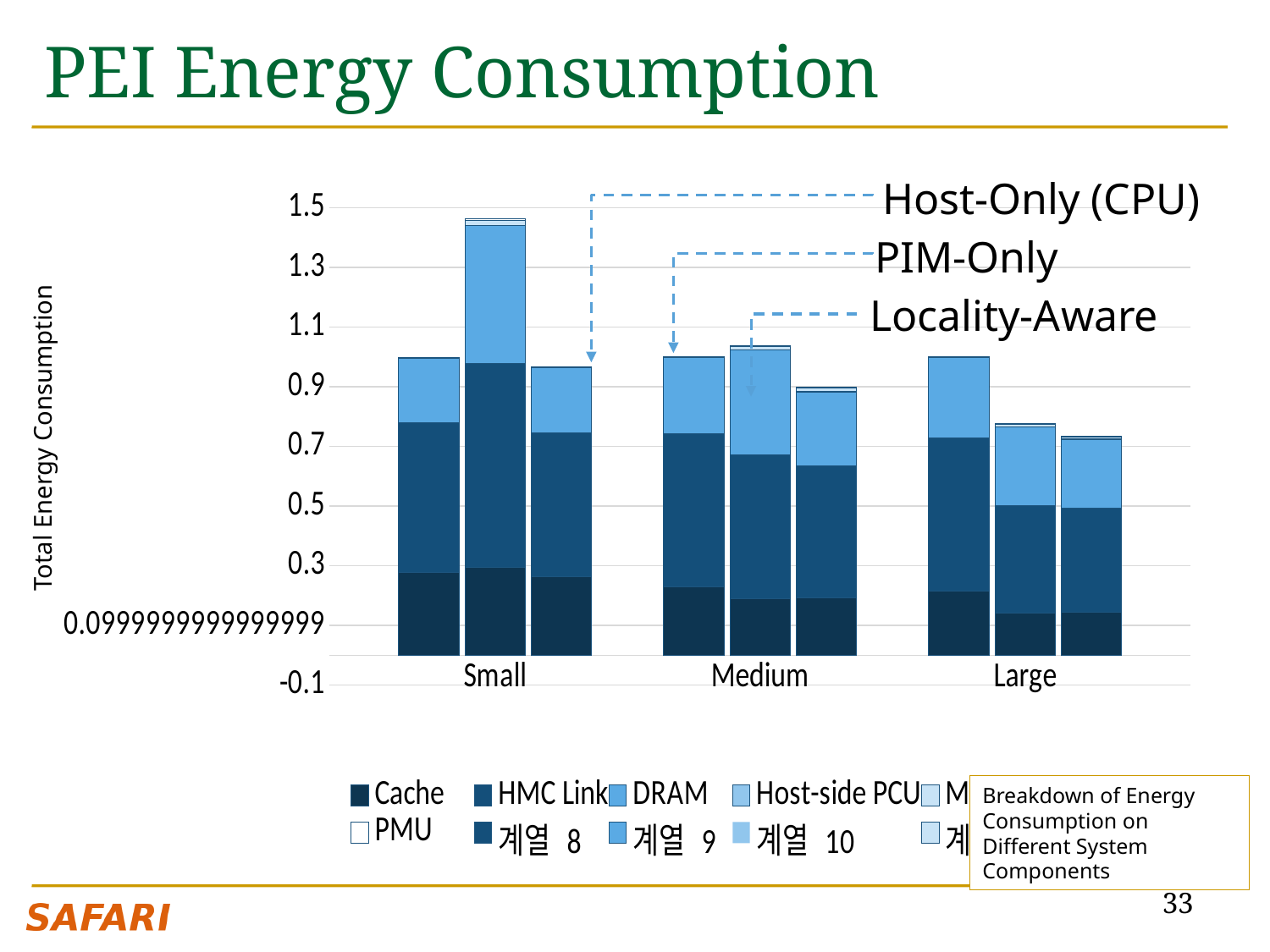
Do the PIM-Only bars rise or fall from Small to Large? fall In the Medium group, which is larger: the PIM-Only bar or the Locality-Aware bar? PIM-Only What is the y-axis title of the chart? Total Energy Consumption Is the total for PIM-Only in the Large group greater or less than 0.9? less Which bar is the tallest in the chart? PIM-Only for Small What kind of chart is shown on the slide? stacked bar chart Which bar is the shortest in the chart? Locality-Aware for Large How many categories are shown on the x axis of the chart? 3 Is the total for Locality-Aware in the Large group greater or less than 0.9? less Is the total for PIM-Only in the Small group greater or less than 1.3? greater In the Small group, which is larger: the Host-Only (CPU) bar or the PIM-Only bar? PIM-Only What are the three categories on the x axis? Small, Medium, Large